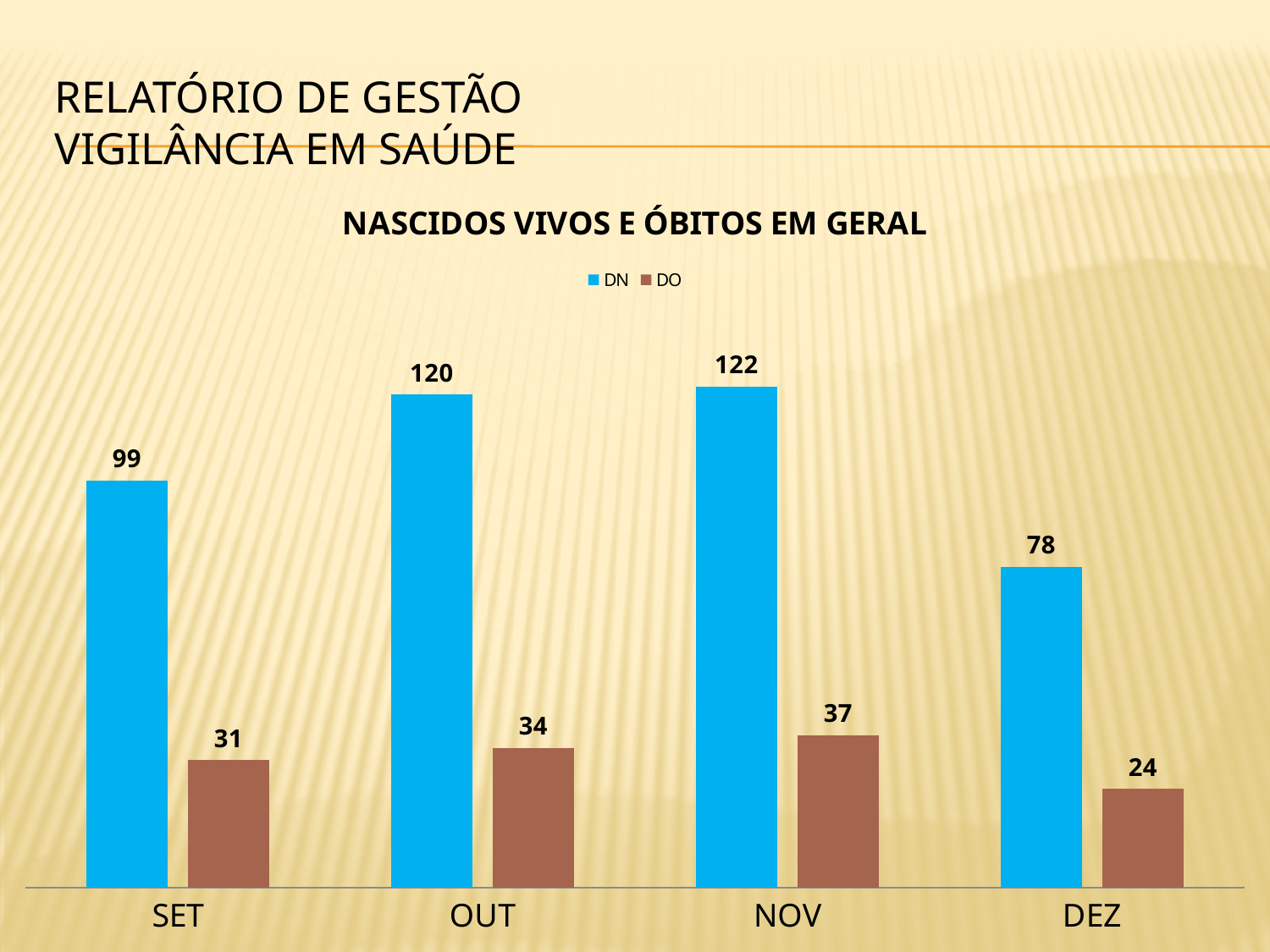
How many series does the legend list? 2 What is the difference between the DN values for NOV and DEZ? 44 What is the DN value for OUT? 120 Which is larger, the DO value for OUT or the DO value for SET? OUT What is the DN value for DEZ? 78 Which month has the lowest DO value? DEZ What is the title of the chart? NASCIDOS VIVOS E ÓBITOS EM GERAL What kind of chart is shown? Bar chart What is the DO value for NOV? 37 Which month has the highest DN value? NOV How many months are shown on the x axis? 4 What is the DO value for SET? 31